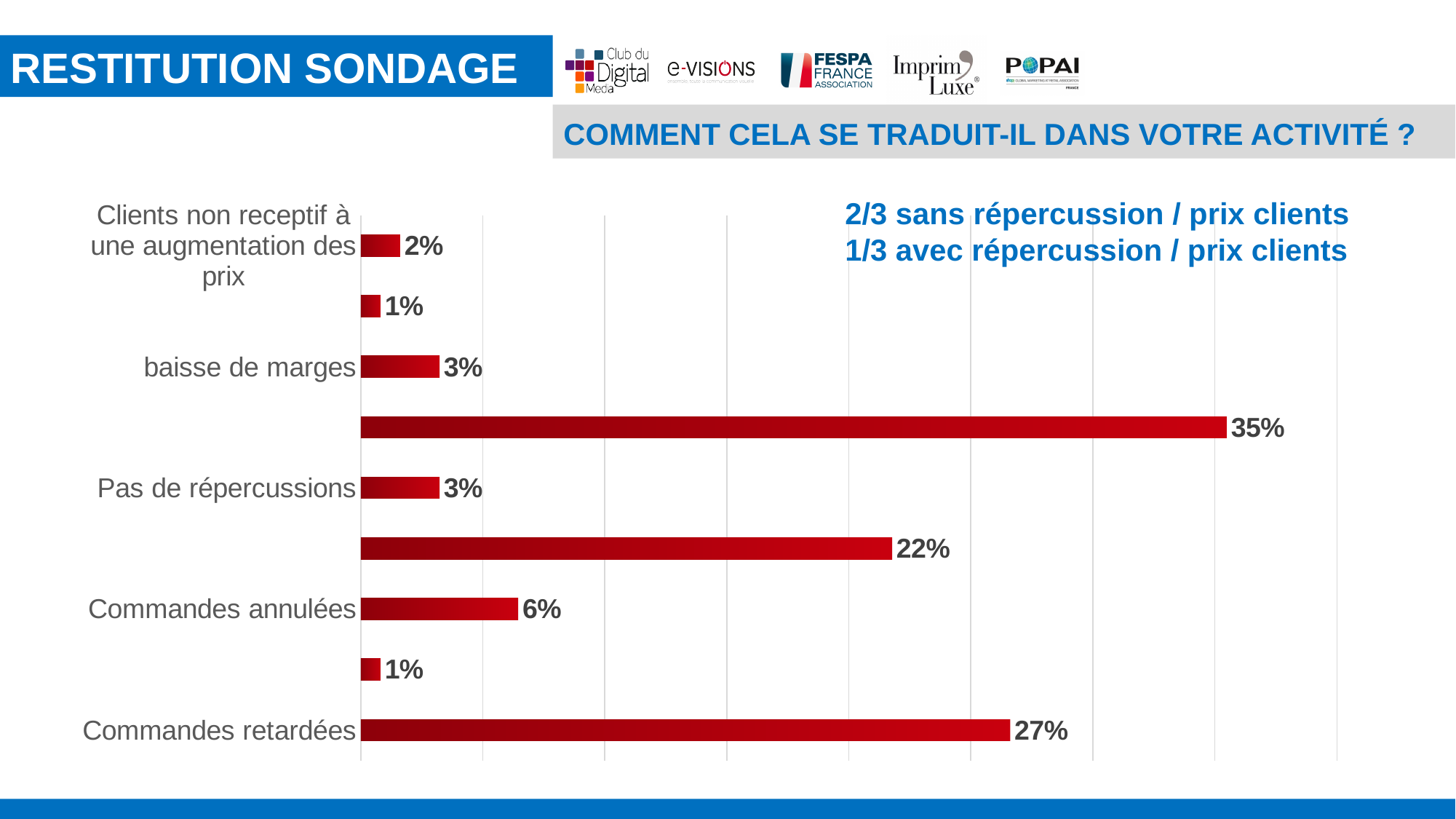
How many bars are plotted on the chart? 9 What is the largest value shown on the chart? 35% What is the difference between the value for "Commandes retardées" and the value for "Commandes annulées"? 21% What is the value for "Commandes annulées"? 6% What is the value for "Pas de répercussions"? 3% Which is larger, the value for "Commandes retardées" or the value for "Commandes annulées"? Commandes retardées What is the value for "baisse de marges"? 3% What is the smallest value shown on the chart? 1% What is the value for "Clients non receptif à une augmentation des prix"? 2% What is the value for "Commandes retardées"? 27% What type of chart is shown on the slide? bar chart What question is written as the heading above the chart? COMMENT CELA SE TRADUIT-IL DANS VOTRE ACTIVITÉ ?